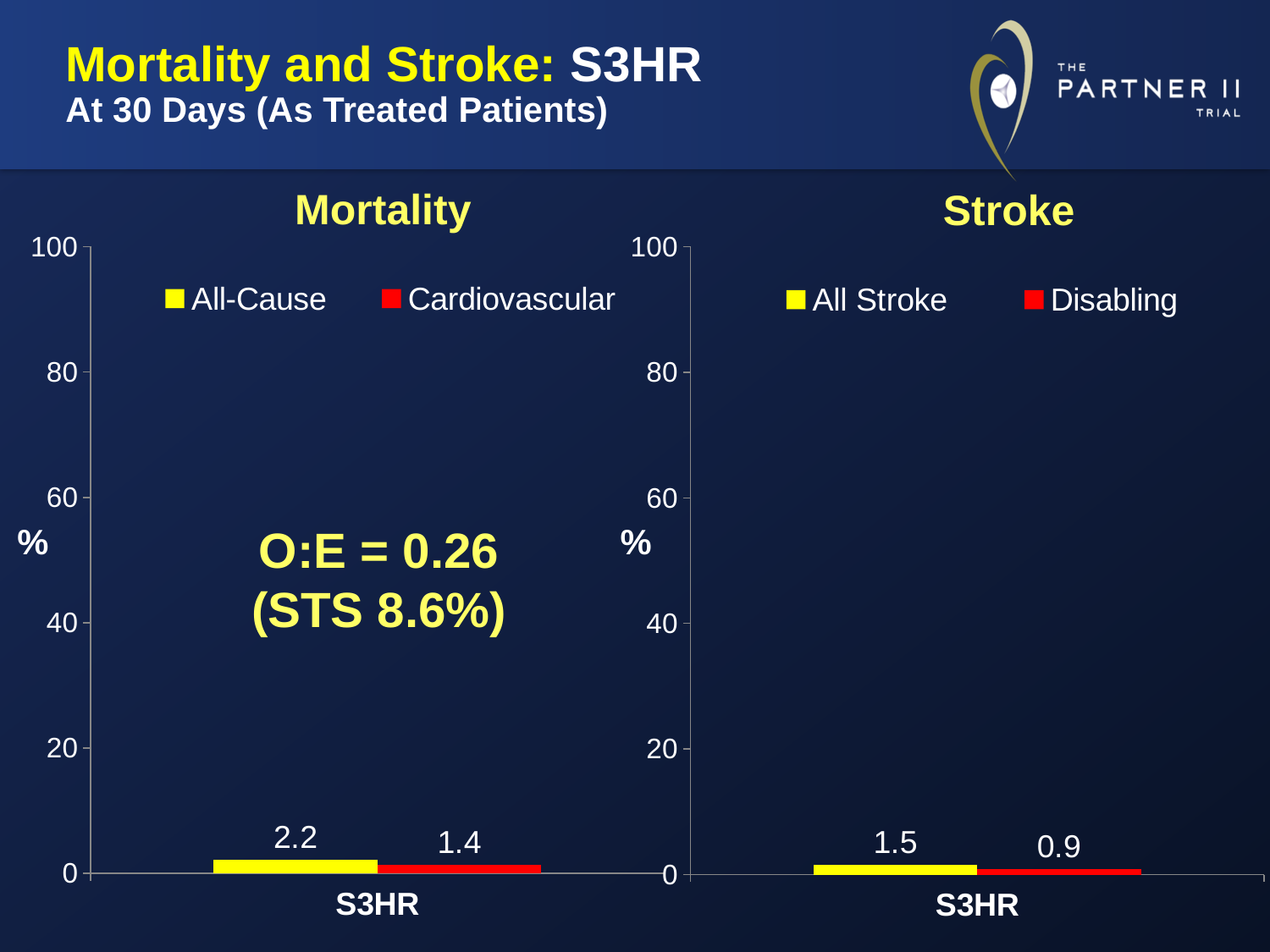
In the Mortality chart, which series has the higher value: All-Cause or Cardiovascular? All-Cause In the Mortality chart, is the value for All-Cause greater or less than 20? less In the Stroke chart, what is the difference between the All Stroke and Disabling values? 0.6 In the Mortality chart, what is the value for All-Cause mortality for S3HR? 2.2 In the Mortality chart, what is the value for Cardiovascular mortality for S3HR? 1.4 How many series does the legend of the Stroke chart list? 2 In the Stroke chart, what is the value for Disabling stroke for S3HR? 0.9 In the Stroke chart, which series has the lower value: All Stroke or Disabling? Disabling In the Stroke chart, what is the value for All Stroke for S3HR? 1.5 In the Mortality chart, what is the difference between the All-Cause and Cardiovascular values? 0.8 In the Mortality chart, what colour is the Cardiovascular series? red What kind of chart is the Mortality chart? bar chart